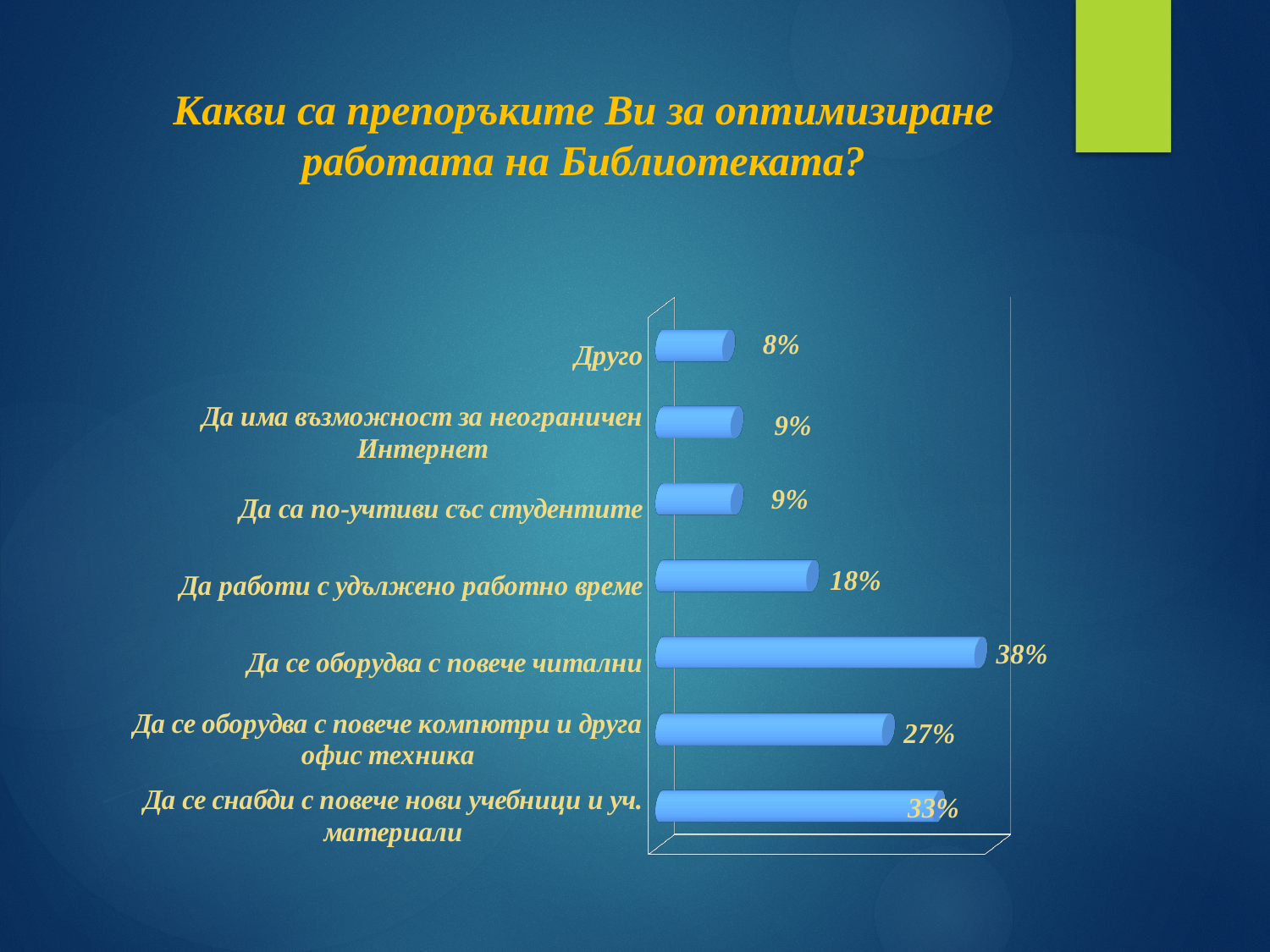
What value is shown for "Да работи с удължено работно време"? 18% Which is larger: the value for "Да се снабди с повече нови учебници и уч. материали" or for "Да се оборудва с повече компютри и друга офис техника"? Да се снабди с повече нови учебници и уч. материали What value is shown for "Да се снабди с повече нови учебници и уч. материали"? 33% What value is shown for "Да се оборудва с повече читални"? 38% What is the difference between the values for "Да се оборудва с повече читални" and "Да се оборудва с повече компютри и друга офис техника"? 11% What is the title of the slide? Какви са препоръките Ви за оптимизиране работата на Библиотеката? What is the difference between the values for "Да работи с удължено работно време" and "Друго"? 10% What value is shown for "Друго"? 8% Which category has the highest value? Да се оборудва с повече читални How many categories are shown in the chart? 7 Which category has the lowest value? Друго What kind of chart is shown on the slide? Bar chart